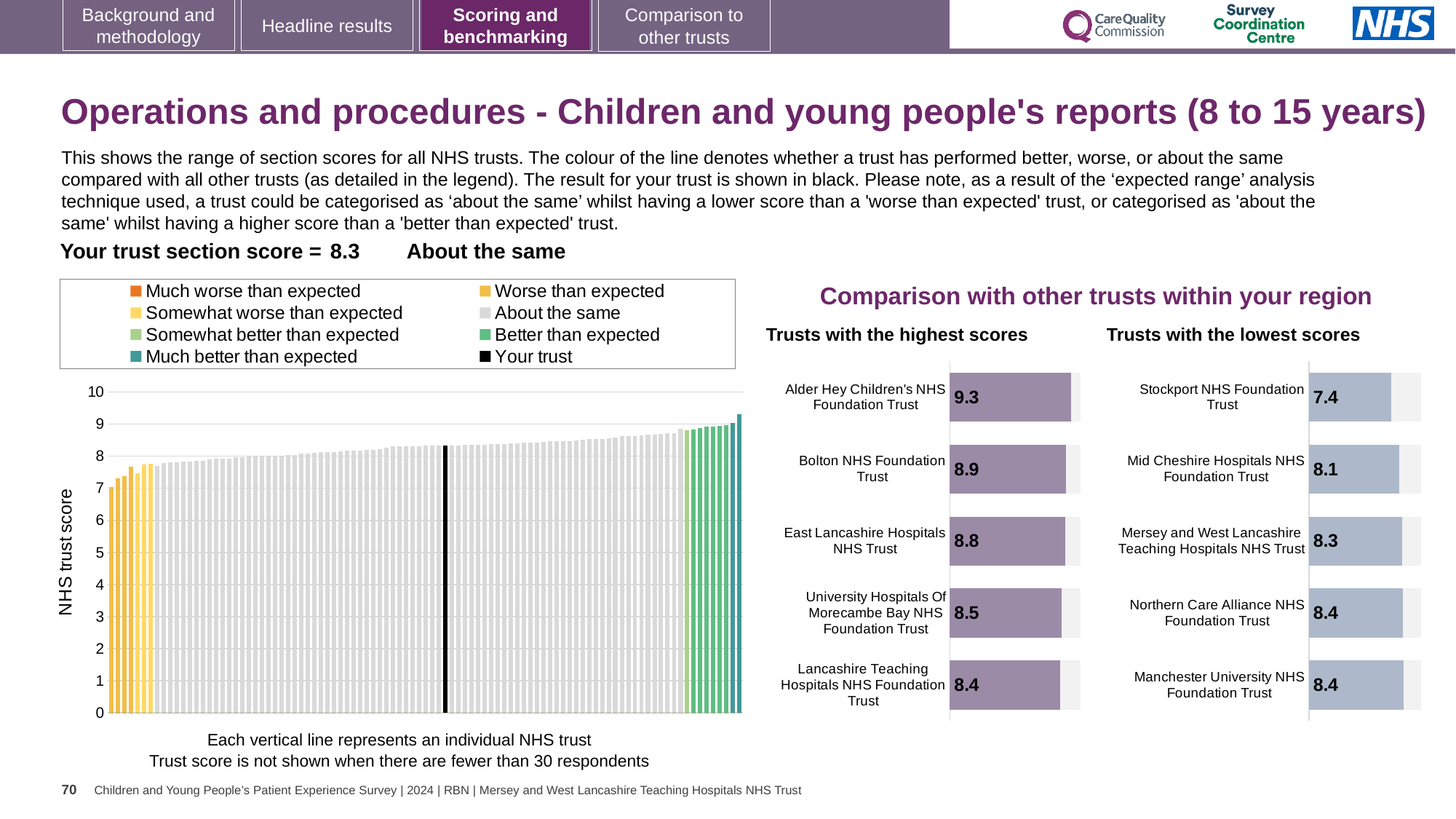
What kind of chart is the main chart showing NHS trust scores on the left of the slide? bar chart What is the difference between the score of Alder Hey Children's NHS Foundation Trust in the highest scores chart and Stockport NHS Foundation Trust in the lowest scores chart? 1.9 In the 'Trusts with the lowest scores' chart, what is the score for Northern Care Alliance NHS Foundation Trust? 8.4 In the 'Trusts with the highest scores' chart, which trust has the highest score? Alder Hey Children's NHS Foundation Trust In the 'Trusts with the highest scores' chart, what is the score for Alder Hey Children's NHS Foundation Trust? 9.3 How many trusts are shown in the 'Trusts with the highest scores' chart? 5 What is your trust's section score shown on the slide? 8.3 How many entries does the legend of the main NHS trust score chart list? 8 In the 'Trusts with the lowest scores' chart, which trust has the lowest score? Stockport NHS Foundation Trust In the 'Trusts with the highest scores' chart, what is the difference between the scores of Alder Hey Children's NHS Foundation Trust and Bolton NHS Foundation Trust? 0.4 In the 'Trusts with the lowest scores' chart, which has the larger score: Stockport NHS Foundation Trust or Mid Cheshire Hospitals NHS Foundation Trust? Mid Cheshire Hospitals NHS Foundation Trust In the main NHS trust score chart, do the bar values rise or fall from left to right? rise